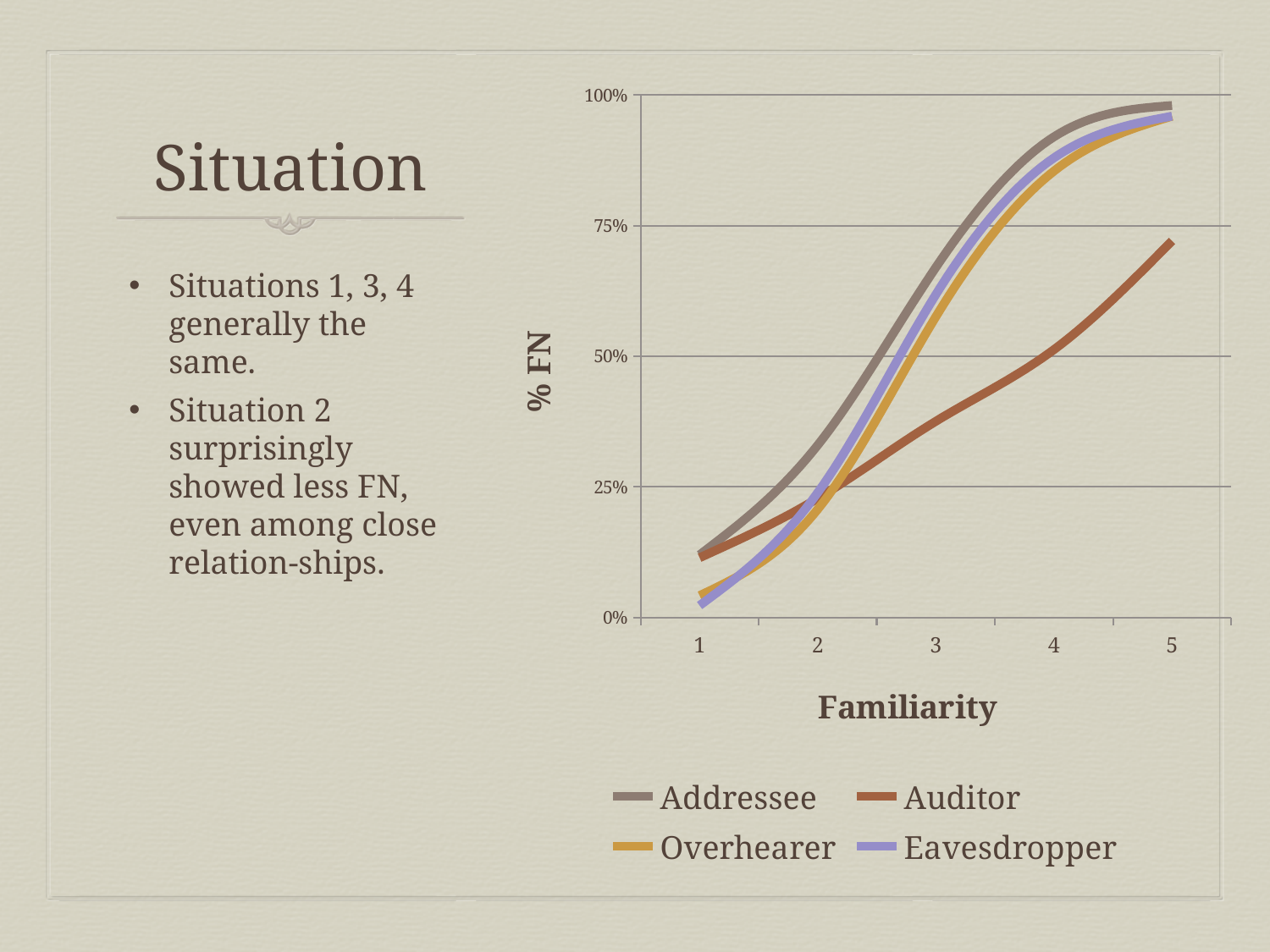
How many series does the chart legend list? 4 Do the values for the Addressee series rise or fall as Familiarity increases from 1 to 5? rise Is the value for Auditor at Familiarity 5 greater or less than 75%? less Which series has the lowest value at Familiarity 5? Auditor What is the title of the vertical axis? % FN How many Familiarity levels are marked along the x axis? 5 Is the value for Addressee at Familiarity 5 greater or less than 75%? greater Is the value for Overhearer at Familiarity 1 greater or less than 25%? less Which series has the highest value at Familiarity 3? Addressee What kind of chart is shown on the slide? line chart At Familiarity 4, which is larger: the value for Auditor or the value for Overhearer? Overhearer